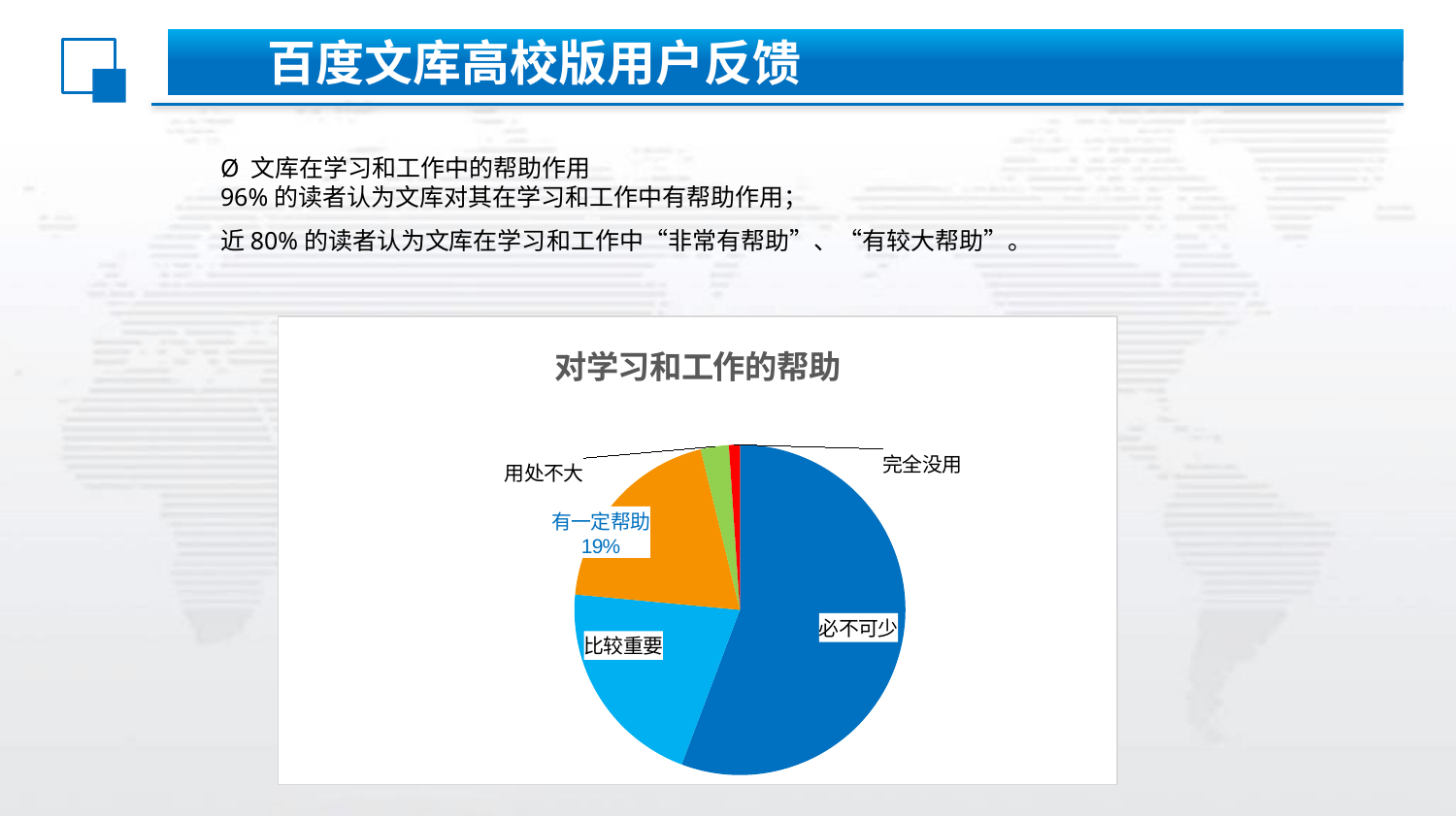
Which slice is larger, 必不可少 or 有一定帮助? 必不可少 Which slice is larger, 有一定帮助 or 用处不大? 有一定帮助 What kind of chart is shown on the slide? pie chart Which category has the smallest slice of the pie? 完全没用 Which slice is larger, 必不可少 or 比较重要? 必不可少 How many slices does the pie chart have? 5 What percentage is shown for the 有一定帮助 slice? 19% What is the title of the chart? 对学习和工作的帮助 Which category has the largest slice of the pie? 必不可少 What colour is the 有一定帮助 slice? orange